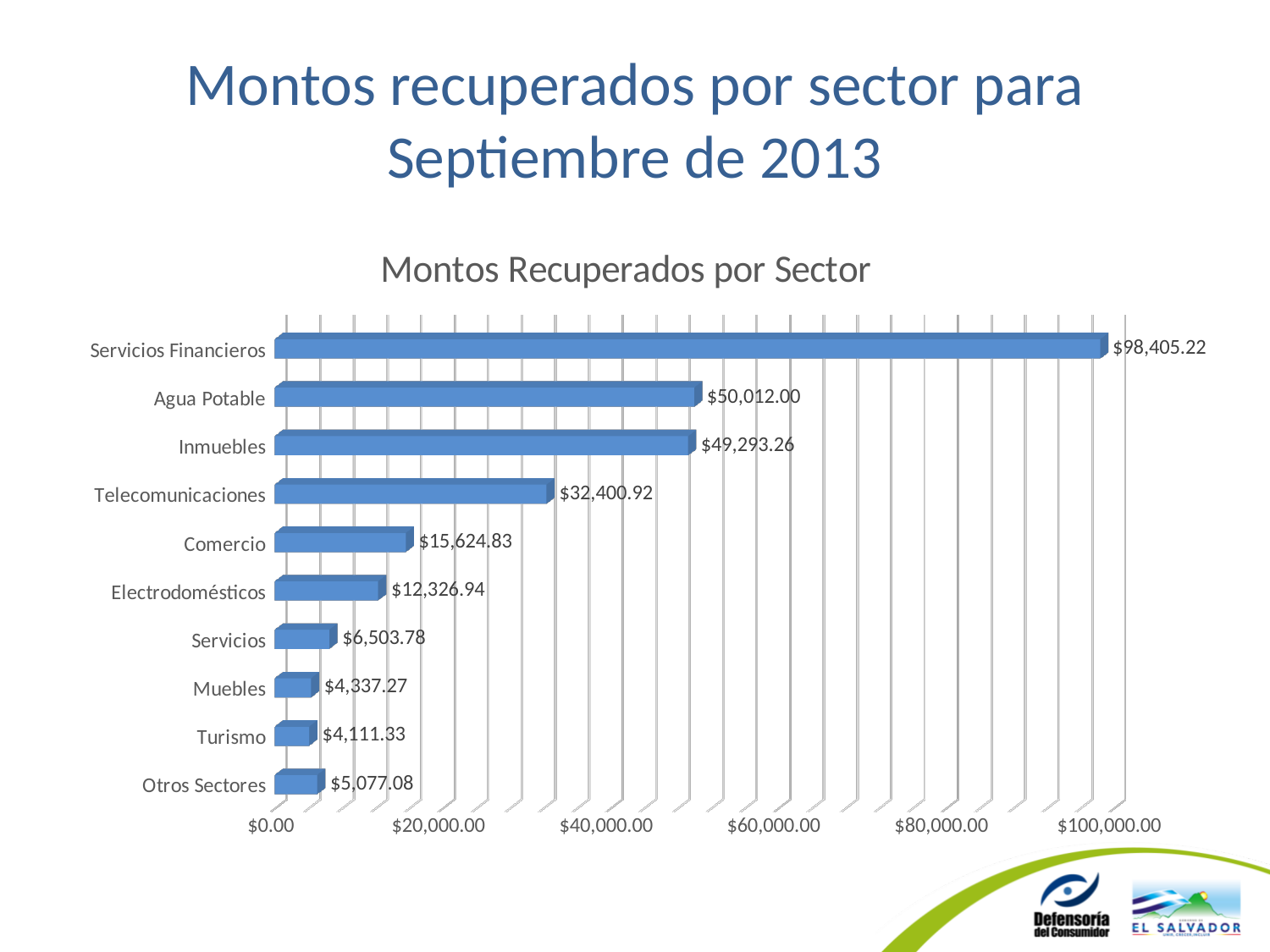
What is the value for Servicios Financieros? $98,405.22 Is the value for Comercio greater or less than $20,000.00? less What is the value for Telecomunicaciones? $32,400.92 What kind of chart is shown on the slide? Bar chart Which sector has the highest recovered amount? Servicios Financieros What is the difference between the values for Servicios Financieros and Agua Potable? $48,393.22 Which sector has the lowest recovered amount? Turismo What is the difference between the values for Agua Potable and Inmuebles? $718.74 What is the value for Otros Sectores? $5,077.08 Which is larger, the value for Otros Sectores or the value for Muebles? Otros Sectores What is the value for Electrodomésticos? $12,326.94 How many sectors are shown in the chart? 10